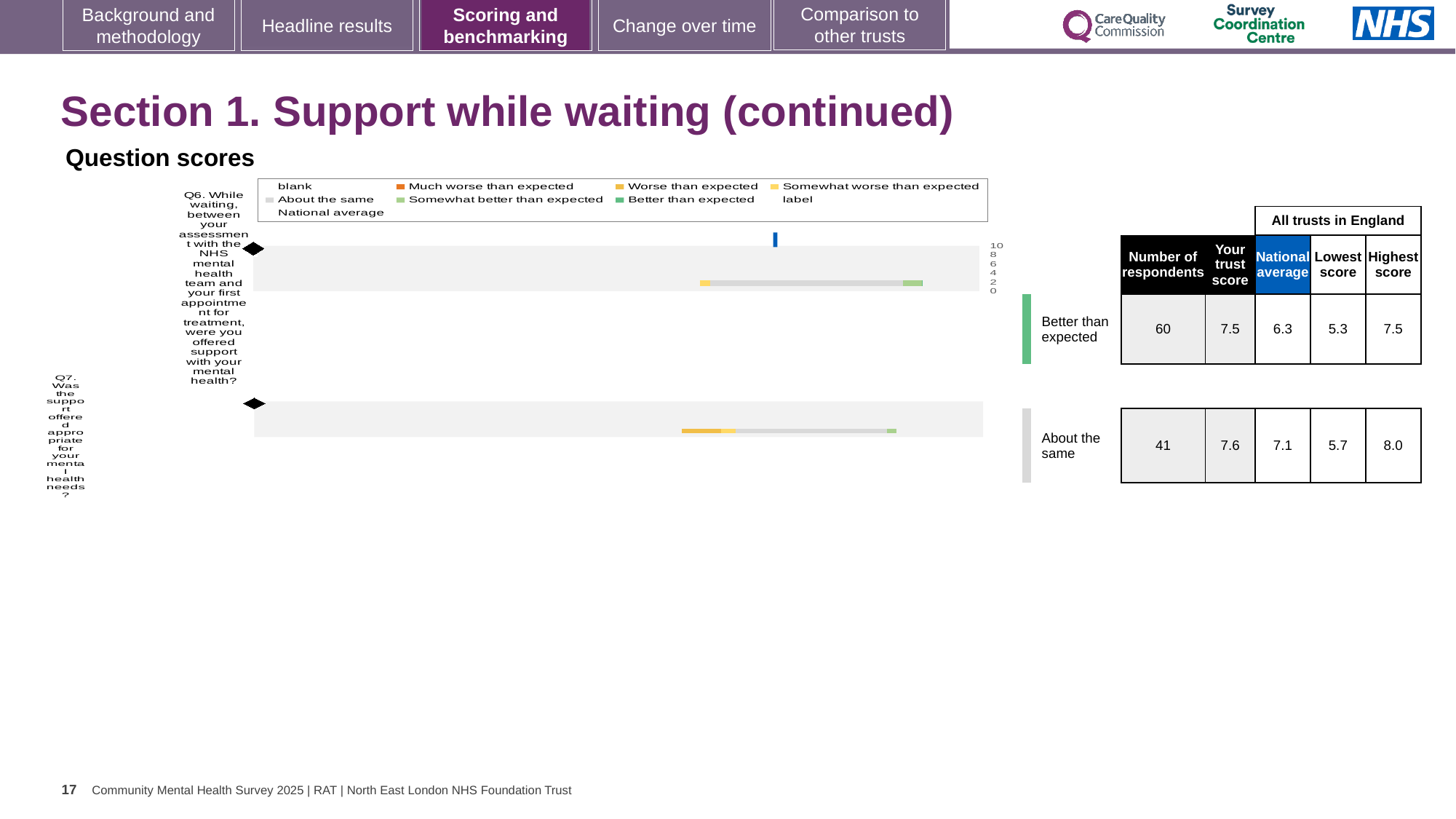
What is the national average score for Q7 (was the support offered appropriate)? 7.1 What is the difference between the highest and lowest scores for Q7? 2.3 Which question has the higher trust score, Q6 or Q7? Q7 How many respondents answered Q6? 60 For Q6, which is larger: the trust score or the national average? the trust score What benchmark category is shown for Q6? Better than expected What kind of chart is used to show the question scores on this slide? bar chart How many questions are plotted in the question scores chart? 2 What is the difference between the trust score and the national average for Q6? 1.2 What is the highest score across all trusts in England for Q7? 8.0 What is the trust score for Q6 (support with mental health while waiting)? 7.5 What benchmark category is shown for Q7? About the same